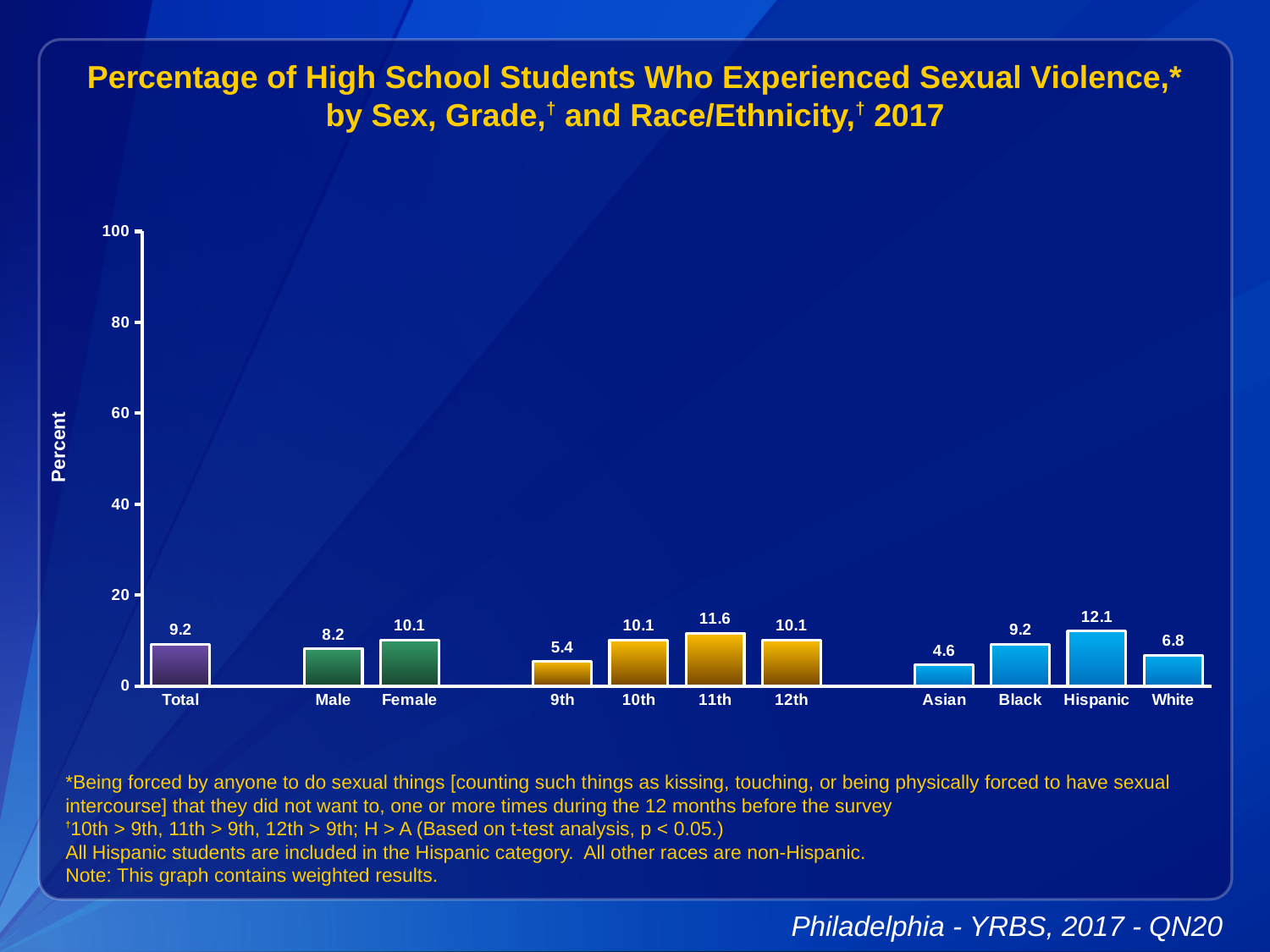
Which is larger, the value for Black or the value for White? Black What kind of chart is this? bar chart What is the difference between the values for Female and Male? 1.9 Which category has the highest value? Hispanic What is the value for Female? 10.1 Is the value for 9th grade greater or less than 20? less How many categories are shown on the x axis? 11 What is the value for 11th grade? 11.6 What is the value for Total? 9.2 What is the label on the y axis? Percent Which category has the lowest value? Asian What is the value for Asian students? 4.6